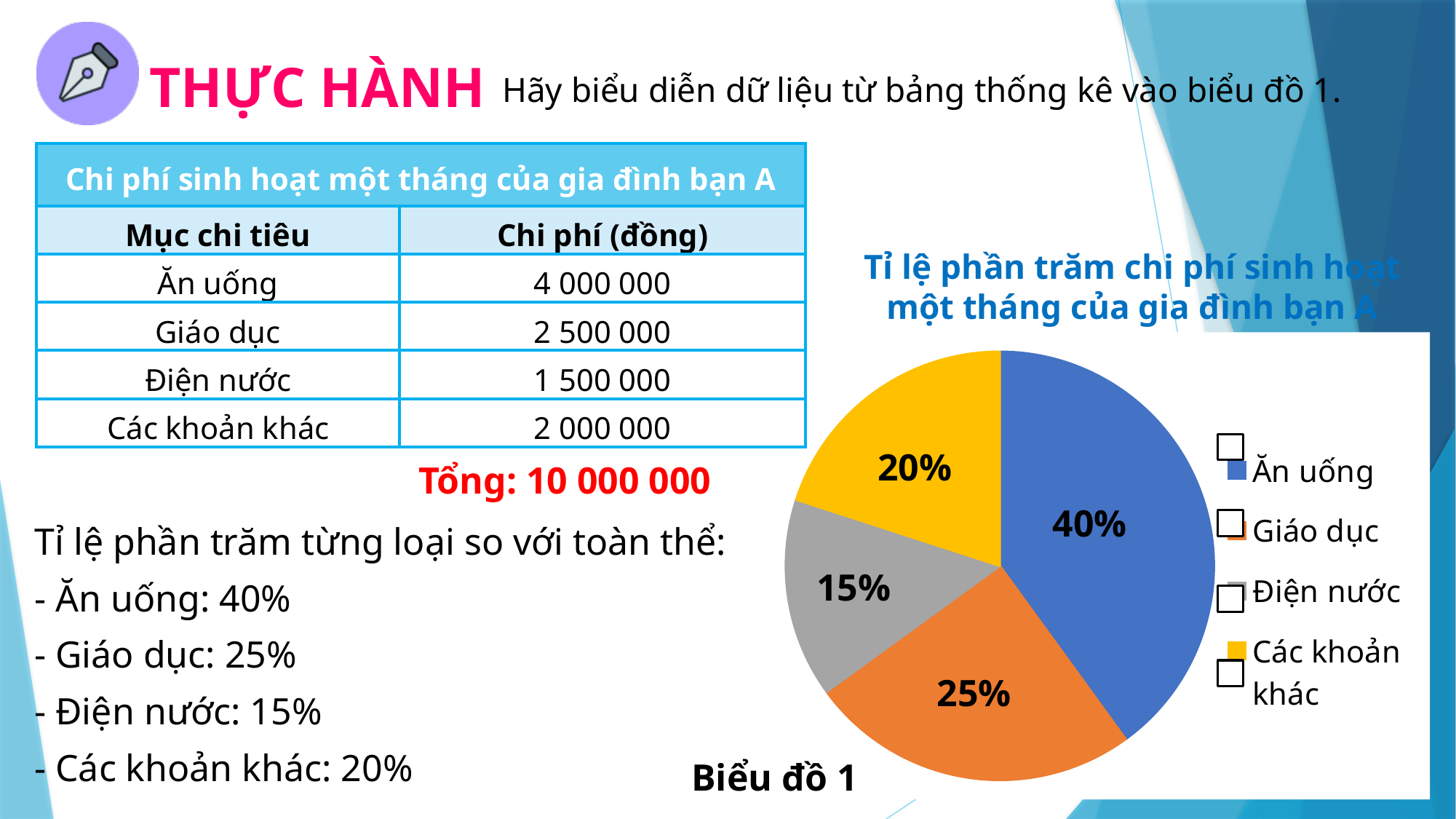
How many slices does the pie chart have? 4 What percentage does the pie chart show for Điện nước? 15% What colour is the Giáo dục slice in the pie chart? Orange What kind of chart is shown on the slide? Pie chart What percentage does the pie chart show for Giáo dục? 25% Which slice is larger in the pie chart, Các khoản khác or Điện nước? Các khoản khác Which category has the largest slice in the pie chart? Ăn uống What percentage does the pie chart show for Ăn uống? 40% What percentage does the pie chart show for Các khoản khác? 20% What is the difference in percentage points between the Ăn uống slice and the Giáo dục slice? 15% Which category has the smallest slice in the pie chart? Điện nước How many entries does the pie chart's legend list? 4